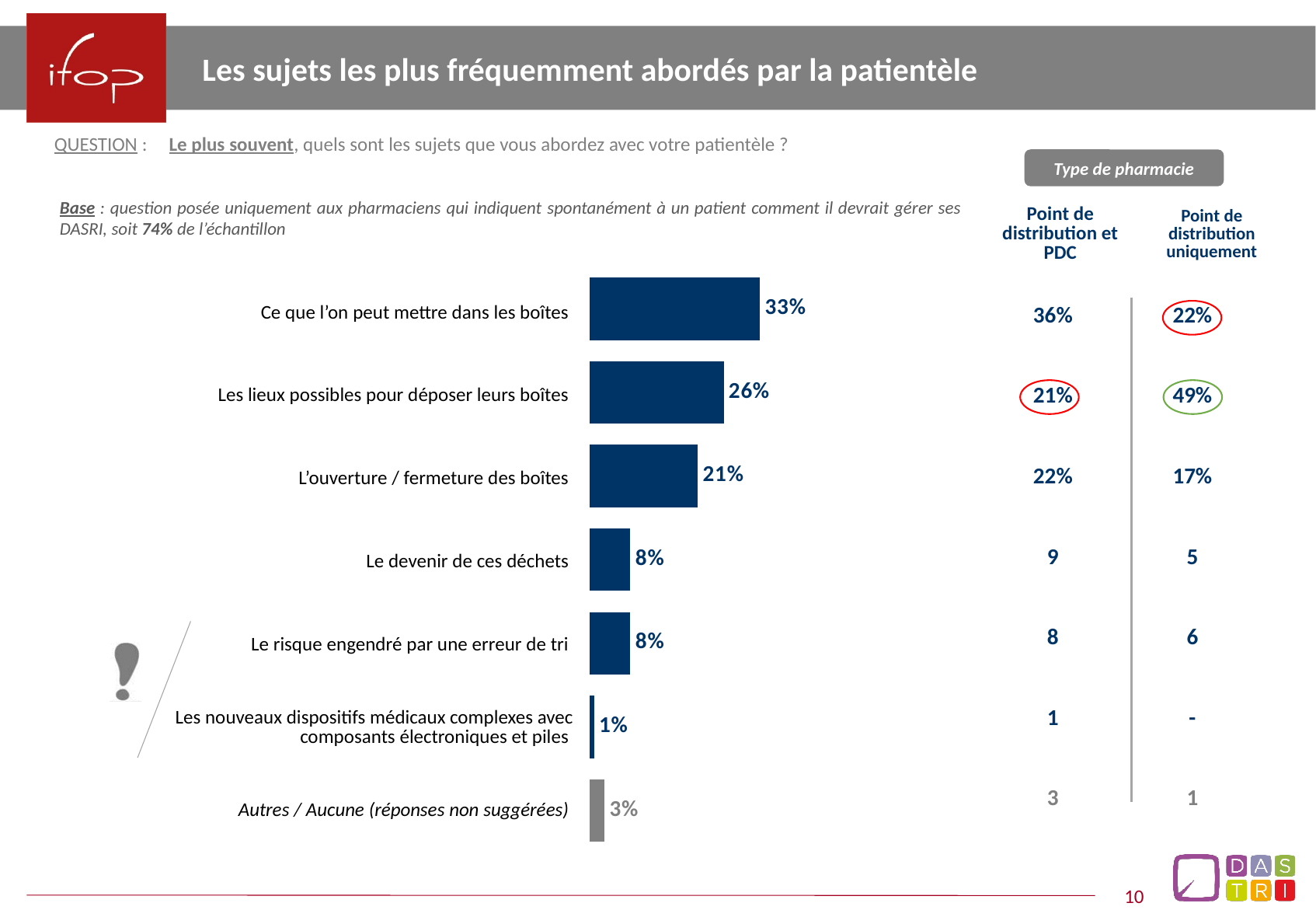
How many categories are shown in the bar chart? 7 What is the difference between the values for "Les lieux possibles pour déposer leurs boîtes" and "L'ouverture / fermeture des boîtes"? 5 percentage points What colour is the bar for "Autres / Aucune (réponses non suggérées)"? Grey Which is larger: the value for "Le devenir de ces déchets" or for "Autres / Aucune (réponses non suggérées)"? Le devenir de ces déchets Which category has the highest value in the bar chart? Ce que l'on peut mettre dans les boîtes What is the difference between the values for "Ce que l'on peut mettre dans les boîtes" and "Les lieux possibles pour déposer leurs boîtes"? 7 percentage points Which category has the lowest value in the bar chart? Les nouveaux dispositifs médicaux complexes avec composants électroniques et piles What kind of chart is shown on the slide? Bar chart What is the value for "Autres / Aucune (réponses non suggérées)"? 3% What is the value for "Les lieux possibles pour déposer leurs boîtes"? 26% What is the value for "L'ouverture / fermeture des boîtes"? 21% What is the value for "Ce que l'on peut mettre dans les boîtes"? 33%